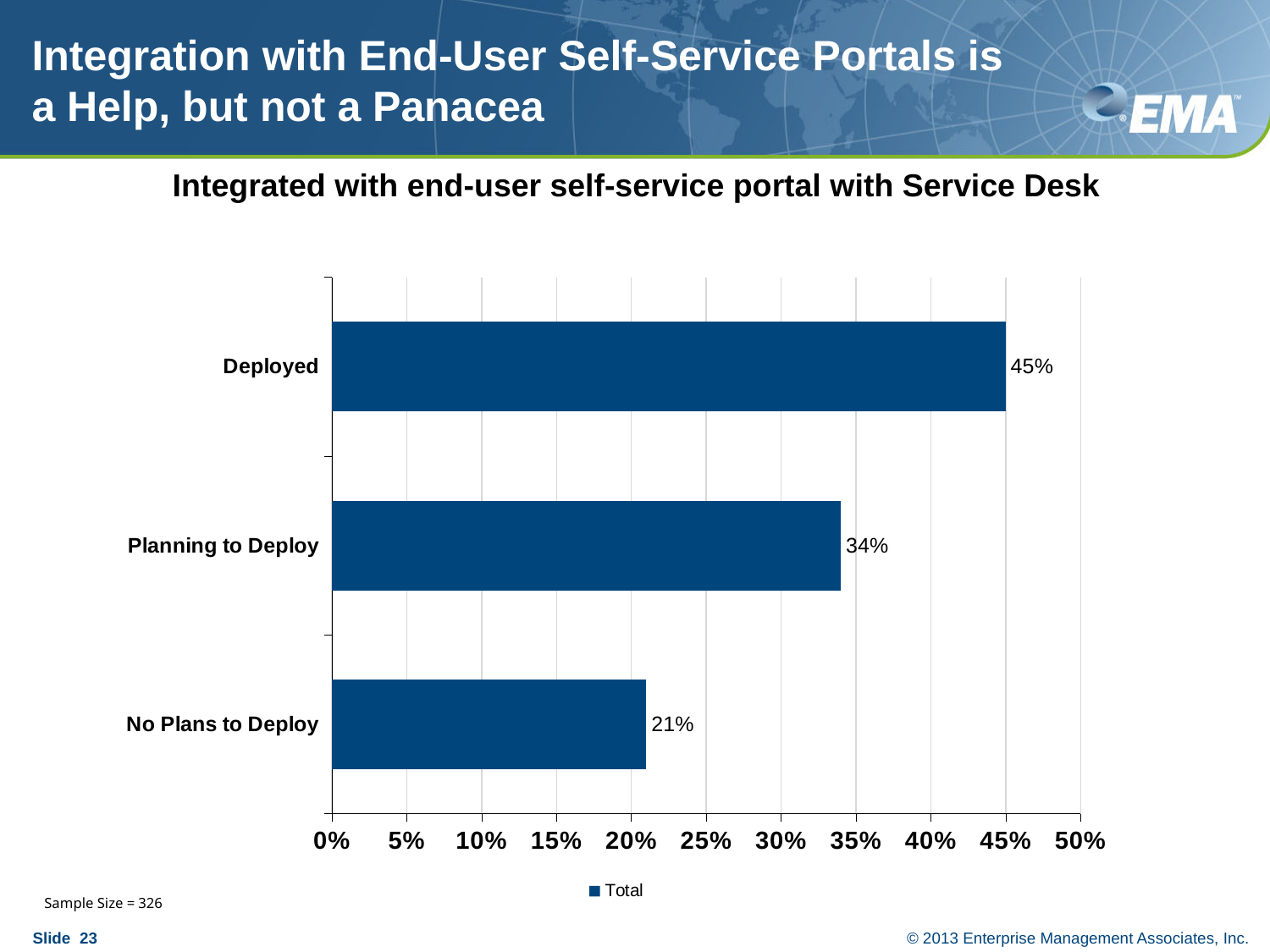
What is the difference between the values for Deployed and Planning to Deploy? 11% What kind of chart is shown on the slide? bar chart What is the value for Planning to Deploy? 34% How many categories are shown in the chart? 3 Which category has the lowest value? No Plans to Deploy Is the value for Deployed greater or less than 40%? greater Which is larger, the value for Planning to Deploy or the value for No Plans to Deploy? Planning to Deploy Which category has the highest value? Deployed What is the difference between the values for Planning to Deploy and No Plans to Deploy? 13% What is the title of the chart? Integrated with end-user self-service portal with Service Desk What is the value for Deployed? 45% What is the value for No Plans to Deploy? 21%